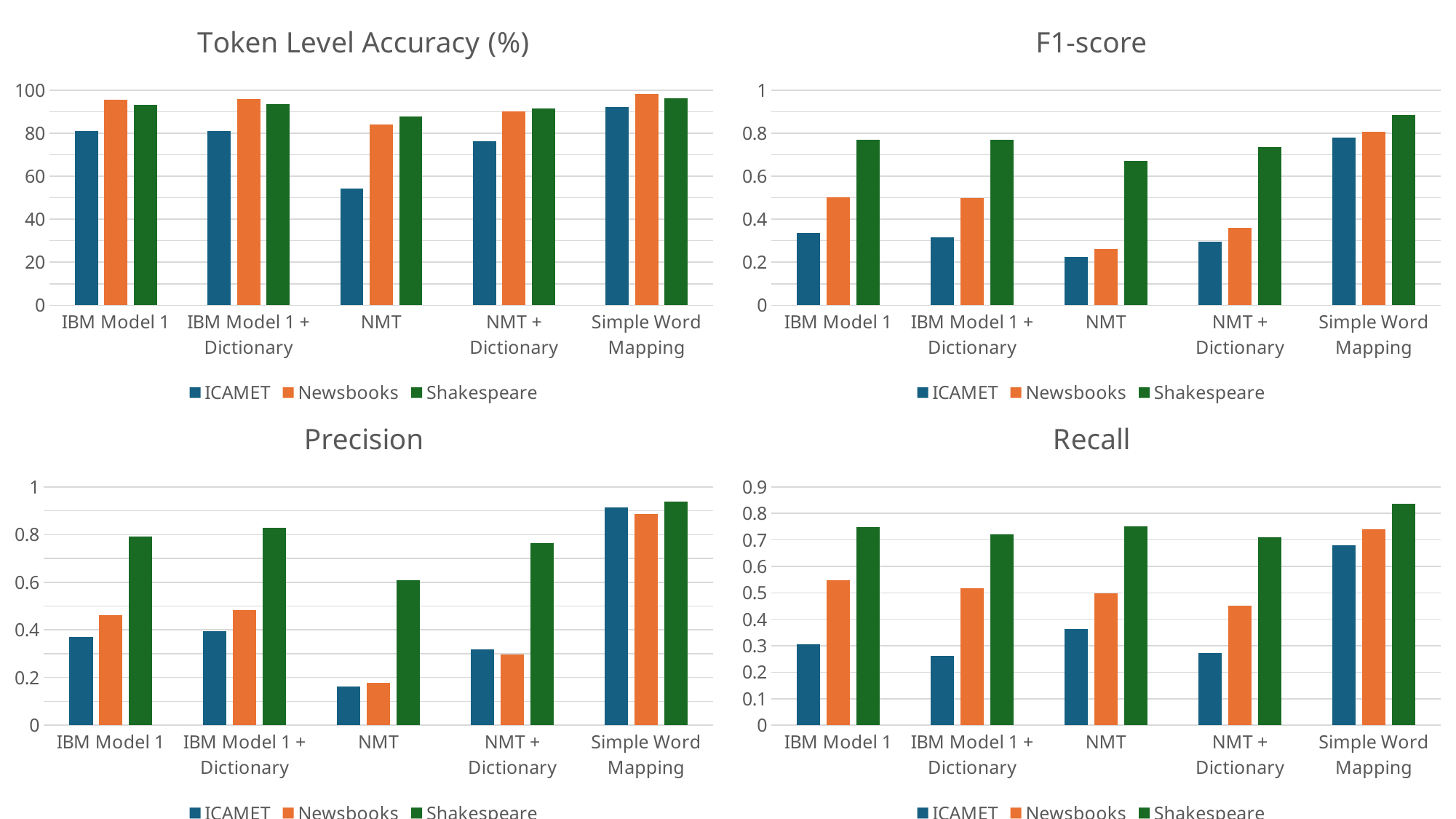
In the F1-score chart, which series has the highest value for IBM Model 1? Shakespeare In the Precision chart, which is larger for Simple Word Mapping: the Newsbooks value or the Shakespeare value? Shakespeare How many series does the legend of the F1-score chart list? 3 In the Recall chart, is the ICAMET value for Simple Word Mapping greater or less than 0.6? greater In the Token Level Accuracy (%) chart, which category has the lowest ICAMET value? NMT What is the title of the chart in the bottom-right of the slide? Recall What kind of chart is the Token Level Accuracy (%) chart? bar chart In the Precision chart, is the ICAMET value for NMT greater or less than 0.2? less In the F1-score chart, is the Shakespeare value for Simple Word Mapping greater or less than 0.8? greater In the Recall chart, which category has the highest Newsbooks value? Simple Word Mapping How many categories are shown on the x axis of the Precision chart? 5